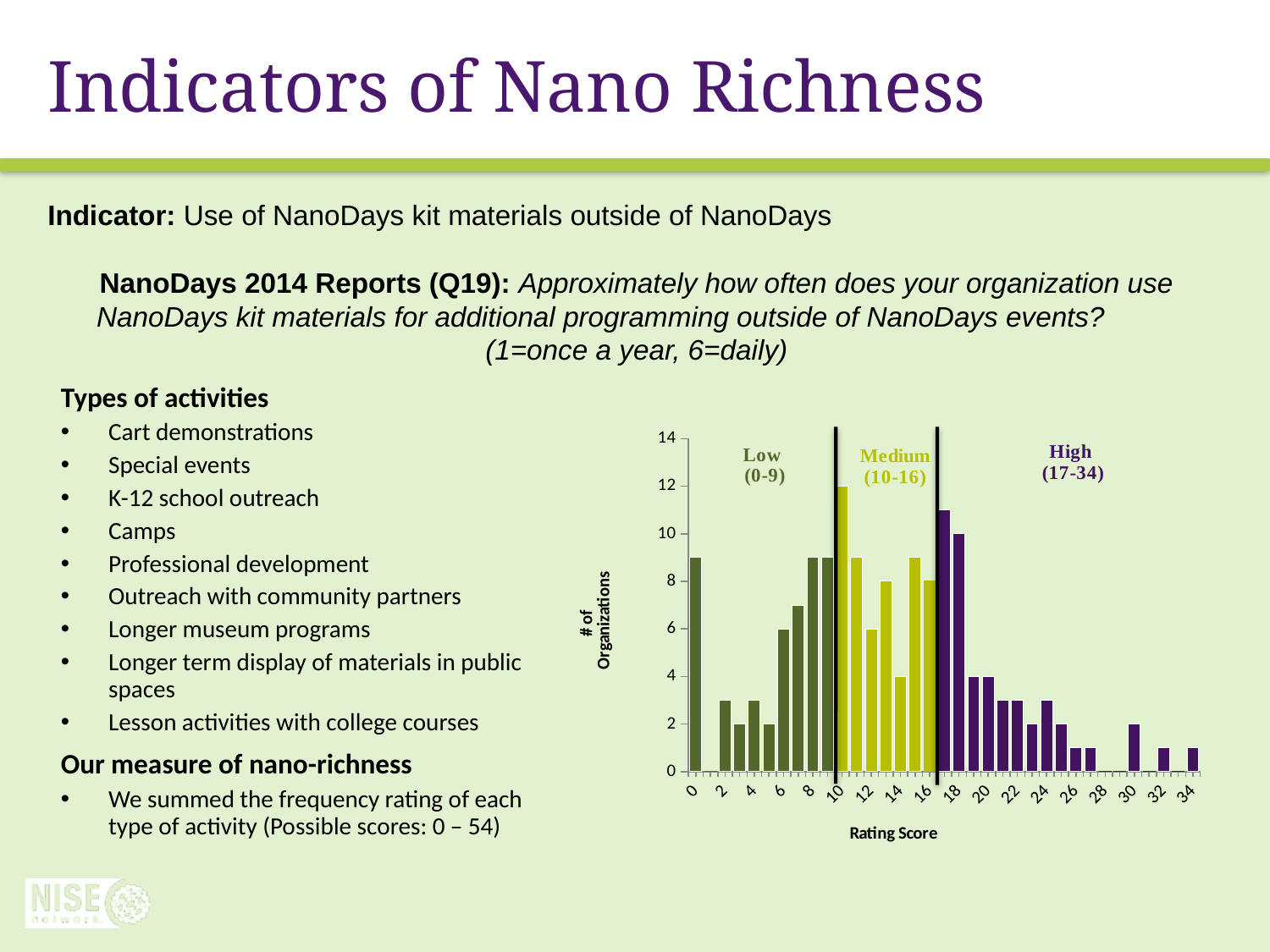
Is the number of organizations at rating score 0 greater or less than 8? greater Which has more organizations: rating score 10 or rating score 18? rating score 10 How many organizations have a rating score of 18? 10 Is the number of organizations at rating score 26 greater or less than 2? less What range of rating scores is labeled as 'High' on the chart? 17-34 Which rating score has the highest number of organizations? 10 How many organizations have a rating score of 10? 12 How many organizations have a rating score of 6? 6 How many organizations have a rating score of 16? 8 What is the difference between the number of organizations at rating score 10 and at rating score 18? 2 What kind of chart is shown on the slide? bar chart What is the title of the x axis of the chart? Rating Score